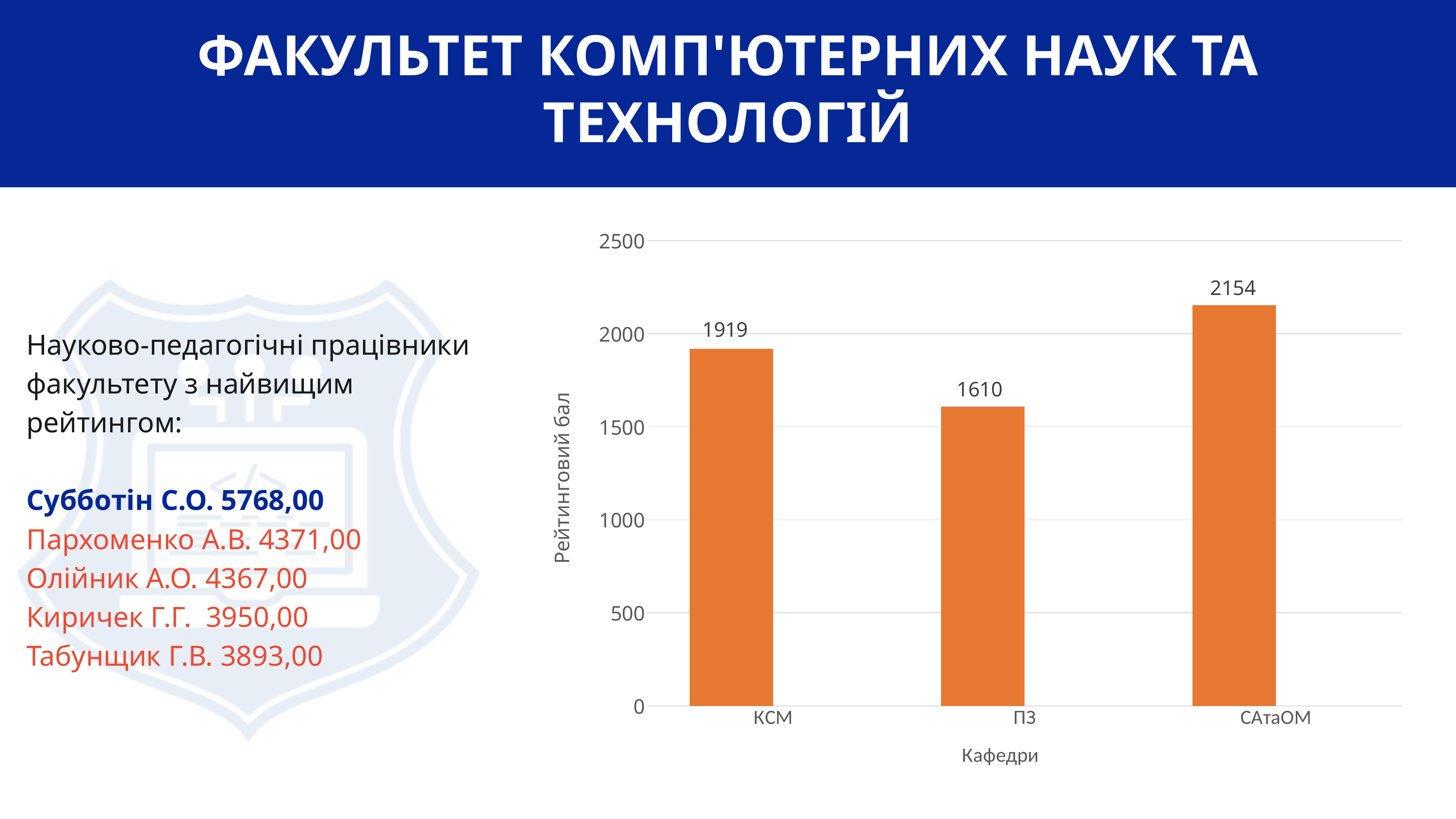
Which is larger, the value for КСМ or the value for ПЗ? КСМ Which department has the highest rating score? САтаОМ How many departments are shown on the chart? 3 What is the value for ПЗ? 1610 Which department has the lowest rating score? ПЗ What is the value for КСМ? 1919 Is the value for САтаОМ greater or less than 2000? greater What is the value for САтаОМ? 2154 What kind of chart is shown on the slide? bar chart What is the label of the vertical axis? Рейтинговий бал What is the difference between the values for КСМ and ПЗ? 309 What is the difference between the values for САтаОМ and КСМ? 235